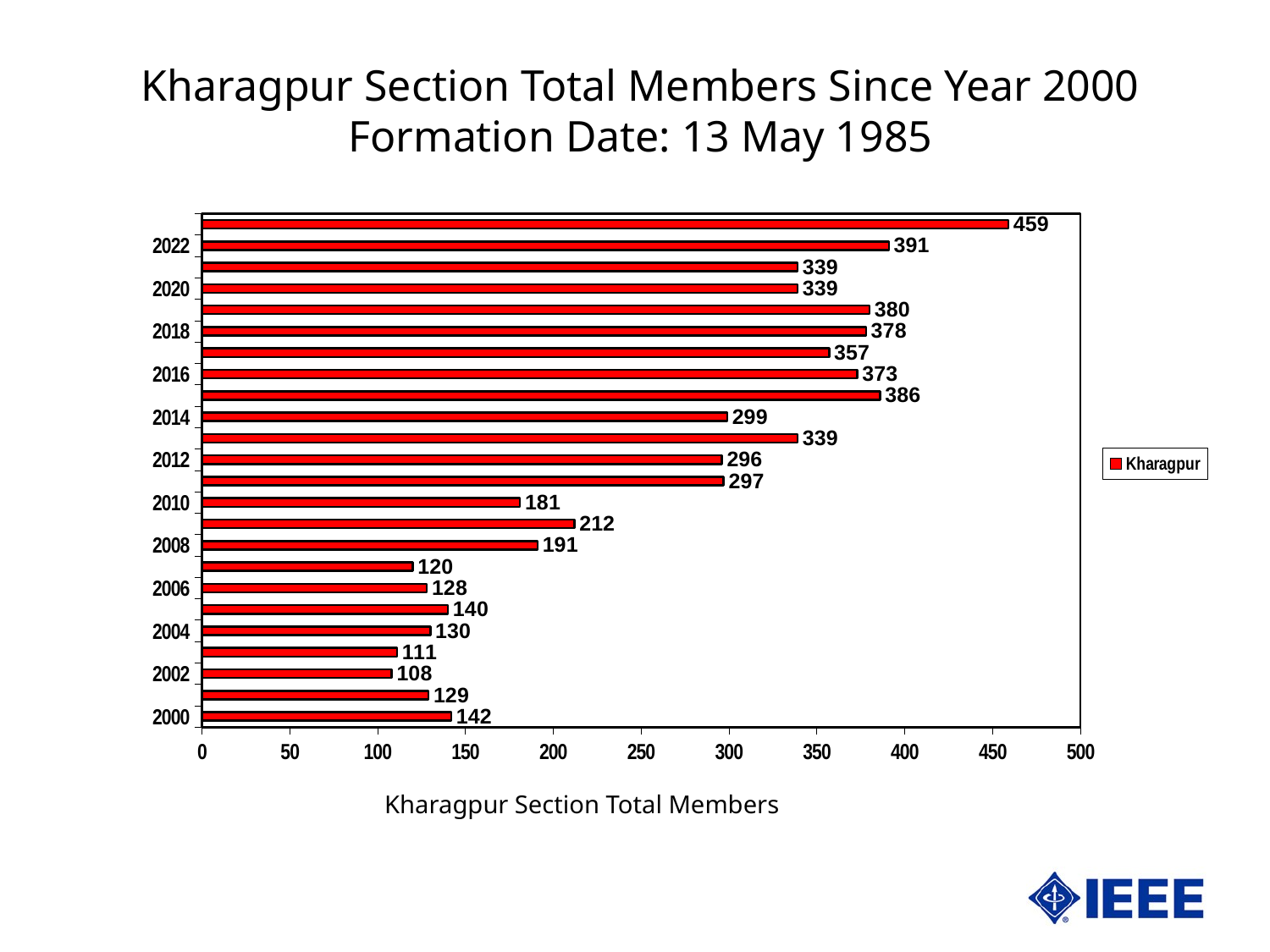
Is the value for 2018 greater or less than 350? greater What is the value for 2010? 181 What is the name of the series shown in the legend? Kharagpur What is the difference between the values for 2022 and 2020? 52 What is the value for 2022? 391 What is the value for 2000? 142 How many series does the legend list? 1 What is the value of the topmost bar in the chart? 459 What is the difference between the values for 2008 and 2006? 63 Which is larger, the value for 2016 or the value for 2014? 2016 What type of chart is shown on the slide? bar chart Which year has the lowest value among the labelled years? 2002